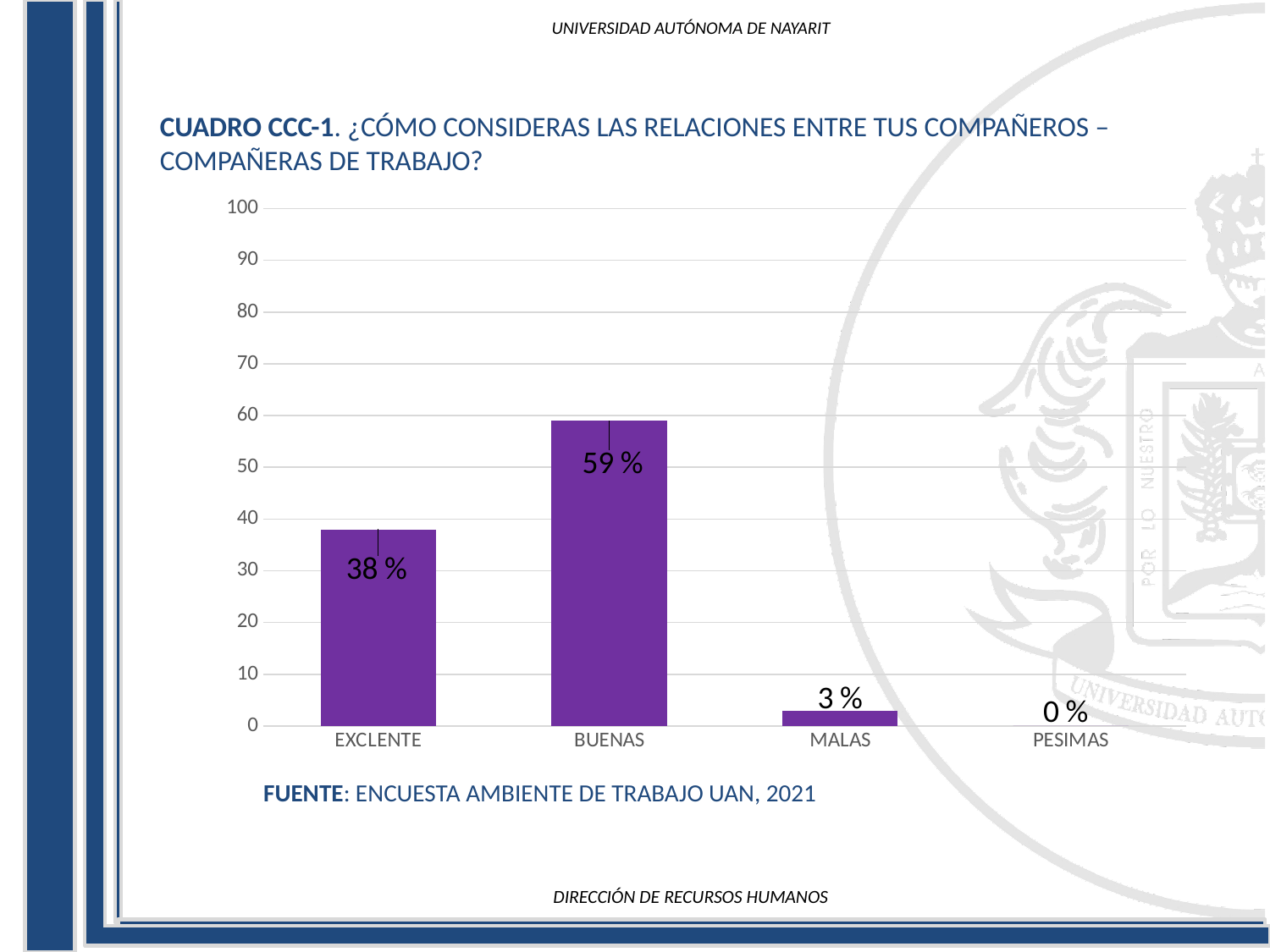
How many categories are shown on the x axis? 4 Which is larger, the value for EXCLENTE or the value for MALAS? EXCLENTE What is the difference between the values for BUENAS and EXCLENTE? 21 % What is the value for PESIMAS? 0 % Is the value for BUENAS greater or less than 50? greater Which category has the lowest value? PESIMAS What is the value for BUENAS? 59 % What source is cited below the chart? ENCUESTA AMBIENTE DE TRABAJO UAN, 2021 Which category has the highest value? BUENAS What is the value for EXCLENTE? 38 % What is the value for MALAS? 3 % What kind of chart is shown on the slide? bar chart